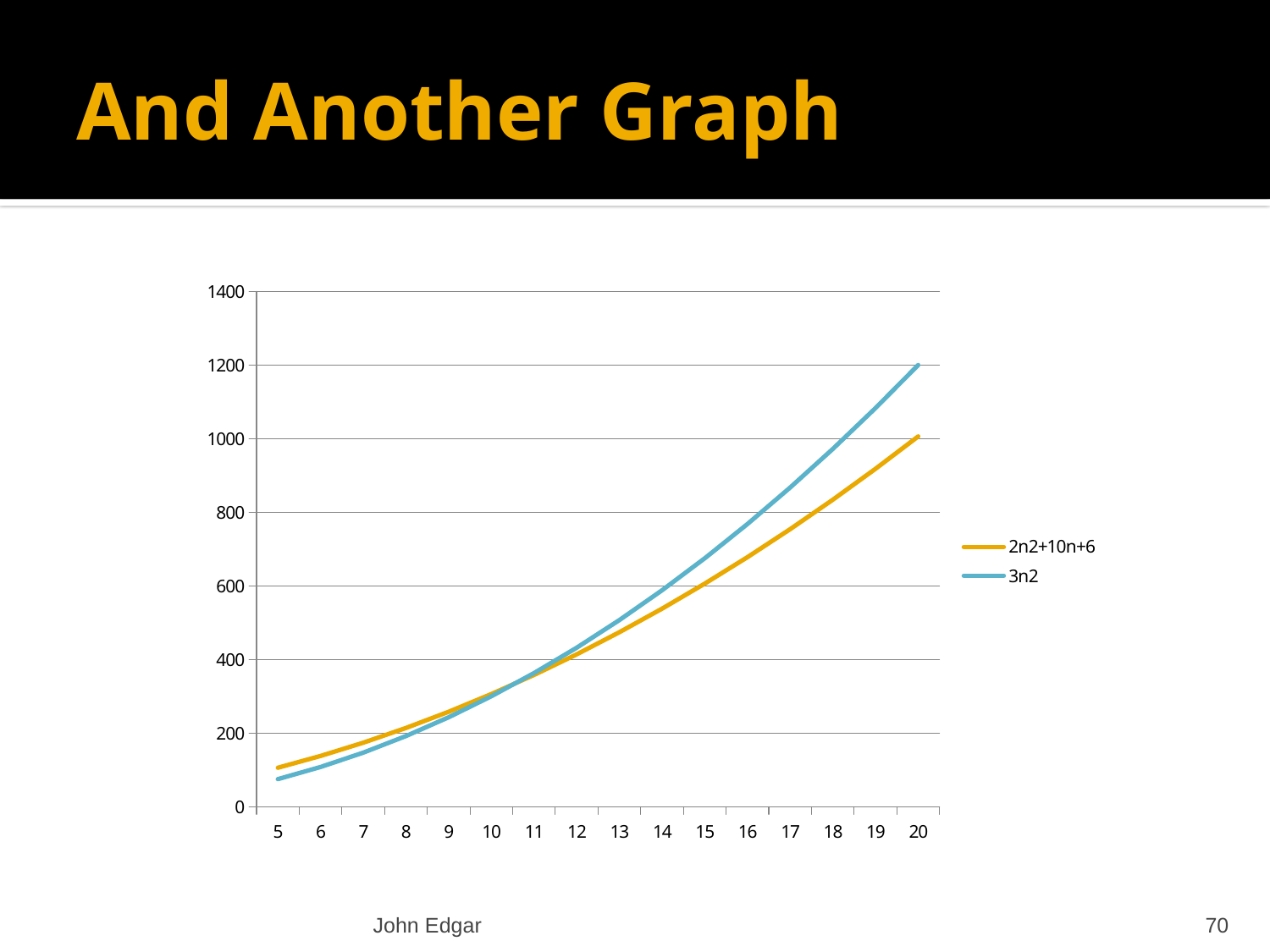
At x = 5, which series has the larger value, 2n2+10n+6 or 3n2? 2n2+10n+6 Do the values of the 3n2 series rise or fall as x increases from 5 to 20? rise Is the value of the 3n2 series at x = 15 greater or less than 600? greater What kind of chart is shown on the slide? line chart At x = 20, which series has the larger value, 2n2+10n+6 or 3n2? 3n2 Do the values of the 2n2+10n+6 series rise or fall along the x axis? rise How many series does the legend list? 2 What is the value of the 3n2 series at x = 20? 1200 Which series is drawn in blue? 3n2 Is the value of the 2n2+10n+6 series at x = 20 greater or less than 1200? less Is the value of the 2n2+10n+6 series at x = 5 greater or less than 200? less How many x-axis points are plotted on the chart? 16